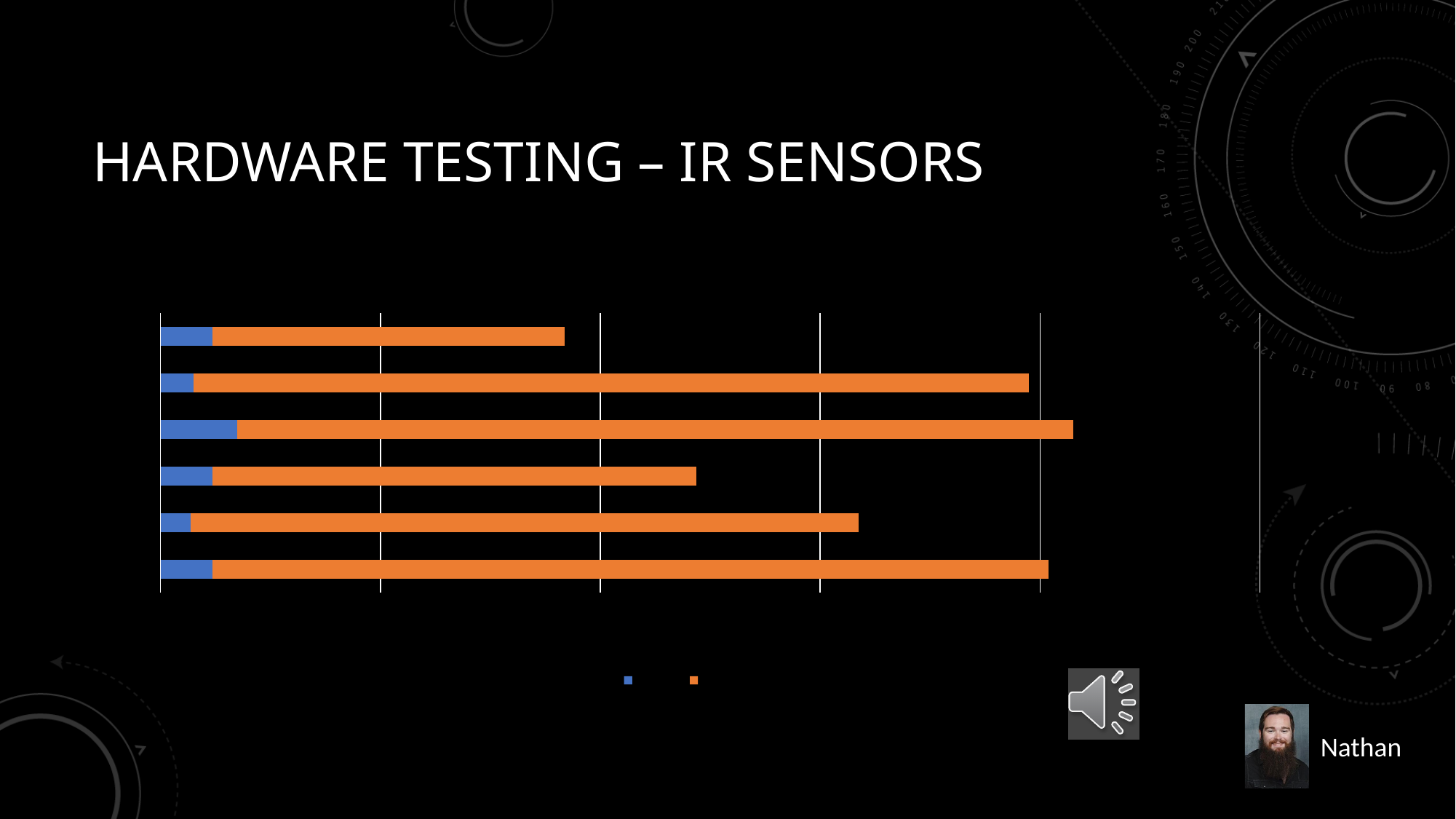
Is the second bar from the top longer or shorter than the fourth bar from the top? longer Counting from the top, which bar is the shortest in the chart? the first bar Is the fifth bar from the top longer or shorter than the sixth bar from the top? shorter What two colours are used for the series in the chart? blue and orange Are the bars in the chart horizontal or vertical? horizontal How many bars (categories) are plotted in the chart? 6 What kind of chart is shown on the slide? bar chart How many series does the chart's legend show? 2 Counting from the top, which bar extends furthest to the right in the chart? the third bar